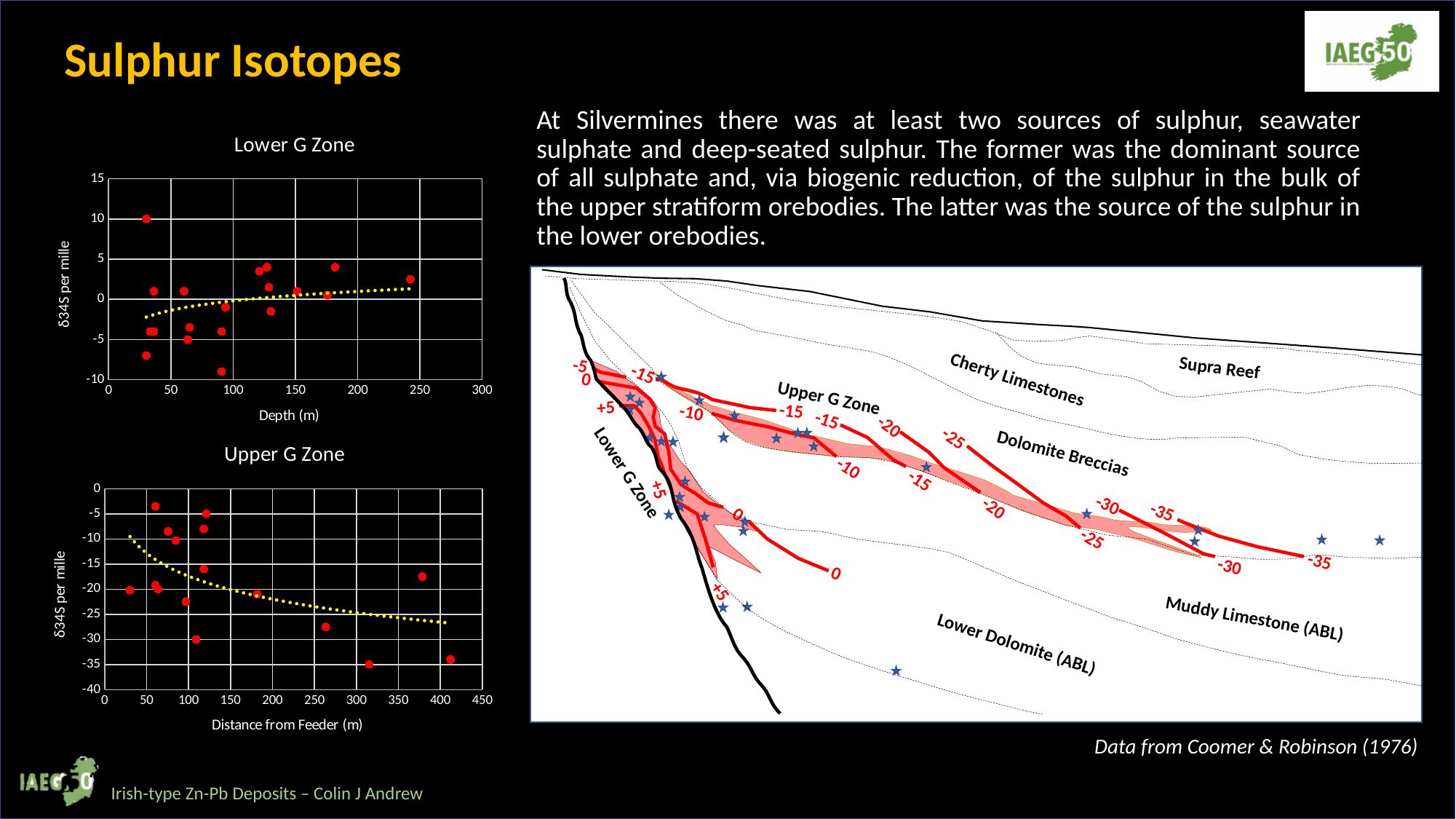
In the Upper G Zone chart, is the lowest plotted δ34S value greater or less than -30? less What kind of chart is the Upper G Zone chart? scatter chart What is the x-axis title of the Lower G Zone chart? Depth (m) In the Upper G Zone chart, is the point plotted at about 380 m distance greater or less than -20 per mille? greater In the Upper G Zone chart, is the point plotted at about 265 m distance greater or less than -25 per mille? less In the Lower G Zone chart, does the dotted trend line rise or fall as depth increases? rise What kind of chart is the Lower G Zone chart? scatter chart In the Upper G Zone chart, does the dotted trend line rise or fall as distance from feeder increases? fall What is the x-axis title of the Upper G Zone chart? Distance from Feeder (m)